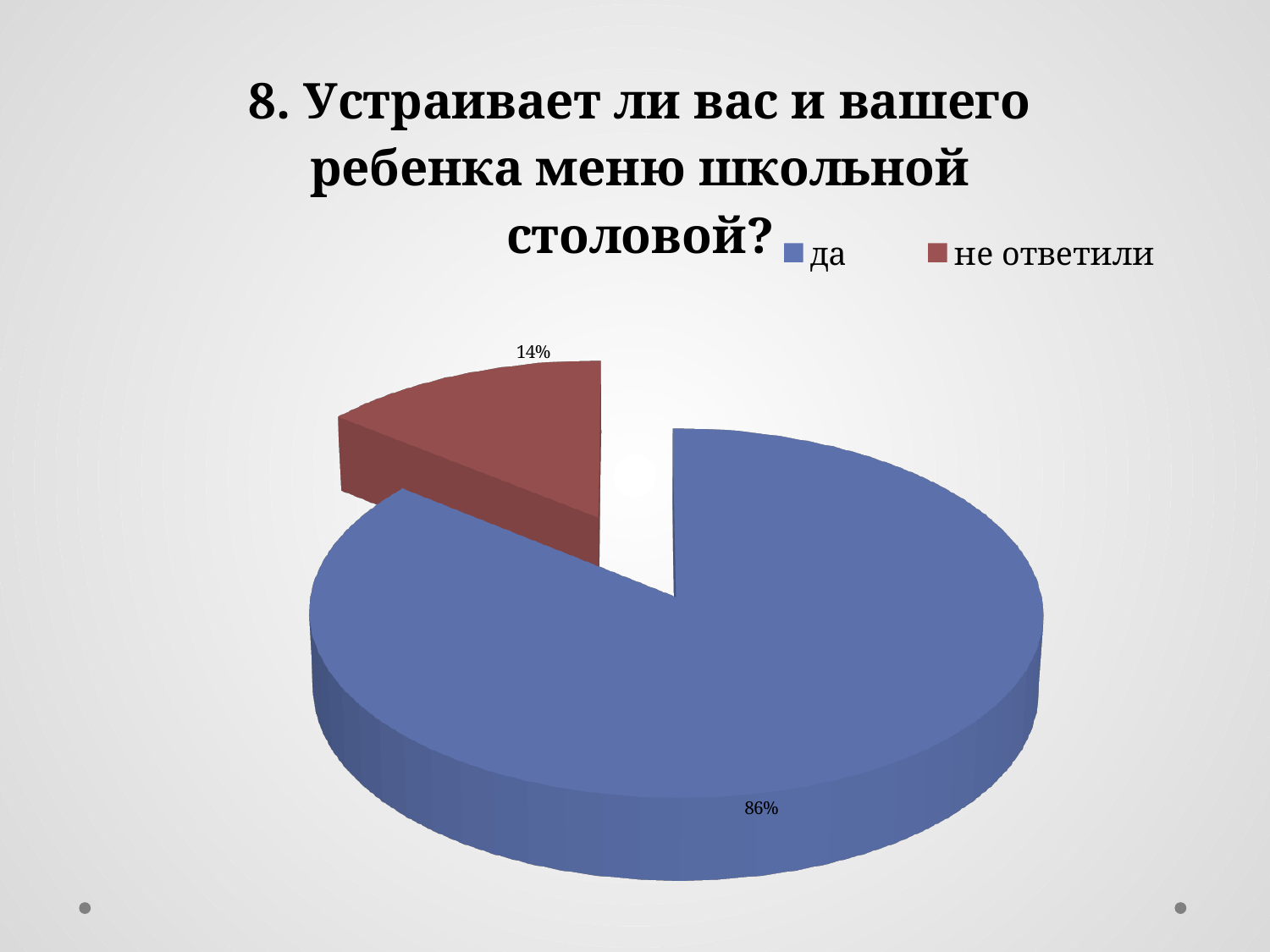
How many slices does the pie chart have? 2 Which is larger: the "да" slice or the "не ответили" slice? да What kind of chart is shown on the slide? pie chart What colour is the "не ответили" slice? red What is the difference in percentage points between the "да" and "не ответили" slices? 72 Which category has the smallest slice of the pie? не ответили What is the title of the chart? 8. Устраивает ли вас и вашего ребенка меню школьной столовой? Which category has the largest slice of the pie? да How many entries does the legend list? 2 What share of the pie does the "не ответили" slice represent? 14% What share of the pie does the "да" slice represent? 86%